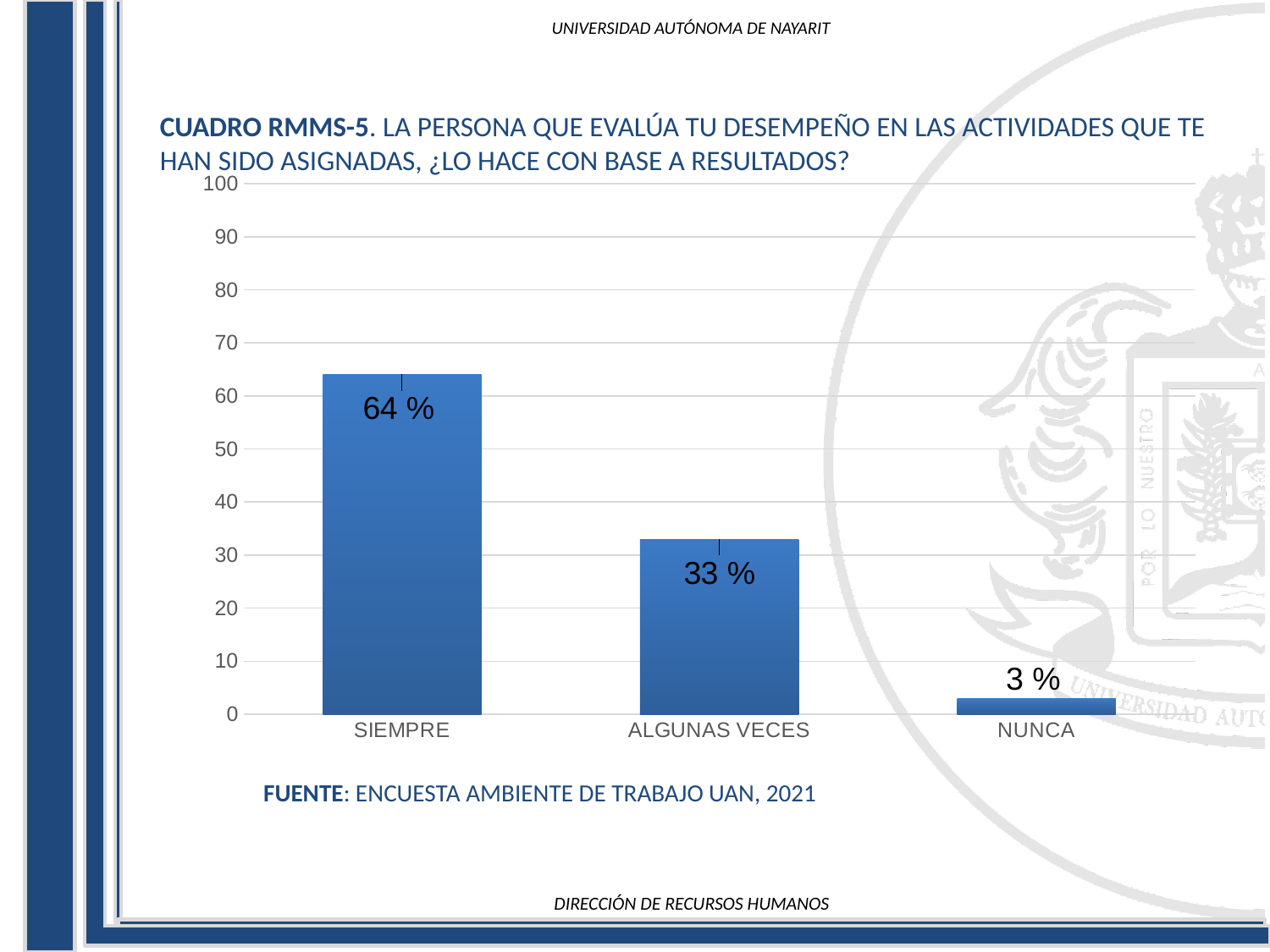
What is the difference between the values for ALGUNAS VECES and NUNCA? 30 % What kind of chart is shown on the slide? bar chart What is the value for ALGUNAS VECES? 33 % Which is larger, the value for ALGUNAS VECES or the value for NUNCA? ALGUNAS VECES Which category has the lowest value? NUNCA Is the value for SIEMPRE greater or less than 50? greater Which category has the highest value? SIEMPRE What is the value for NUNCA? 3 % What is the difference between the values for SIEMPRE and ALGUNAS VECES? 31 % What is the value for SIEMPRE? 64 % How many categories are shown on the x axis? 3 What source is cited below the chart? ENCUESTA AMBIENTE DE TRABAJO UAN, 2021